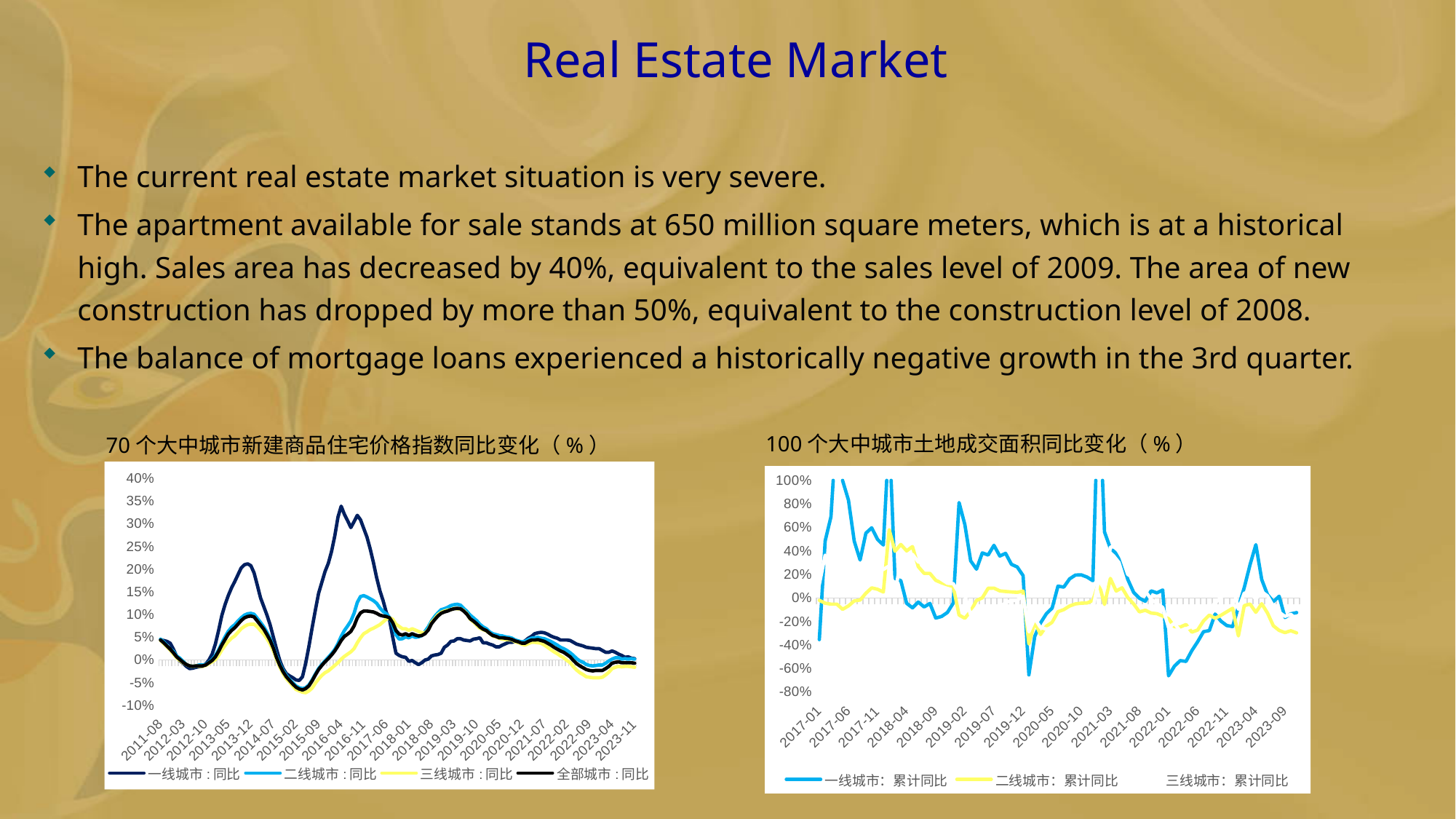
In the right chart (100个大中城市土地成交面积同比变化), which series reaches the lowest value? 一线城市：累计同比 In the left chart (70个大中城市新建商品住宅价格指数同比变化), is the peak value of 一线城市:同比 around 2016-04 greater or less than 30%? greater What kind of chart is the right chart titled 100个大中城市土地成交面积同比变化（%）? line chart What kind of chart is the left chart titled 70个大中城市新建商品住宅价格指数同比变化（%）? line chart In the left chart (70个大中城市新建商品住宅价格指数同比变化), around 2016-04, which is larger: 一线城市:同比 or 三线城市:同比? 一线城市:同比 In the left chart (70个大中城市新建商品住宅价格指数同比变化), do the series generally rise or fall from 2019-03 to 2023-11? fall In the left chart (70个大中城市新建商品住宅价格指数同比变化), which series reaches the highest peak value? 一线城市:同比 In the left chart (70个大中城市新建商品住宅价格指数同比变化), what is the first x-axis label? 2011-08 In the right chart (100个大中城市土地成交面积同比变化), what is the last x-axis label? 2023-09 In the left chart (70个大中城市新建商品住宅价格指数同比变化), how many series does the legend list? 4 In the right chart (100个大中城市土地成交面积同比变化), is the lowest value of 一线城市：累计同比 around 2019-12 to 2020-05 greater or less than -60%? less In the right chart (100个大中城市土地成交面积同比变化), how many series does the legend list? 3